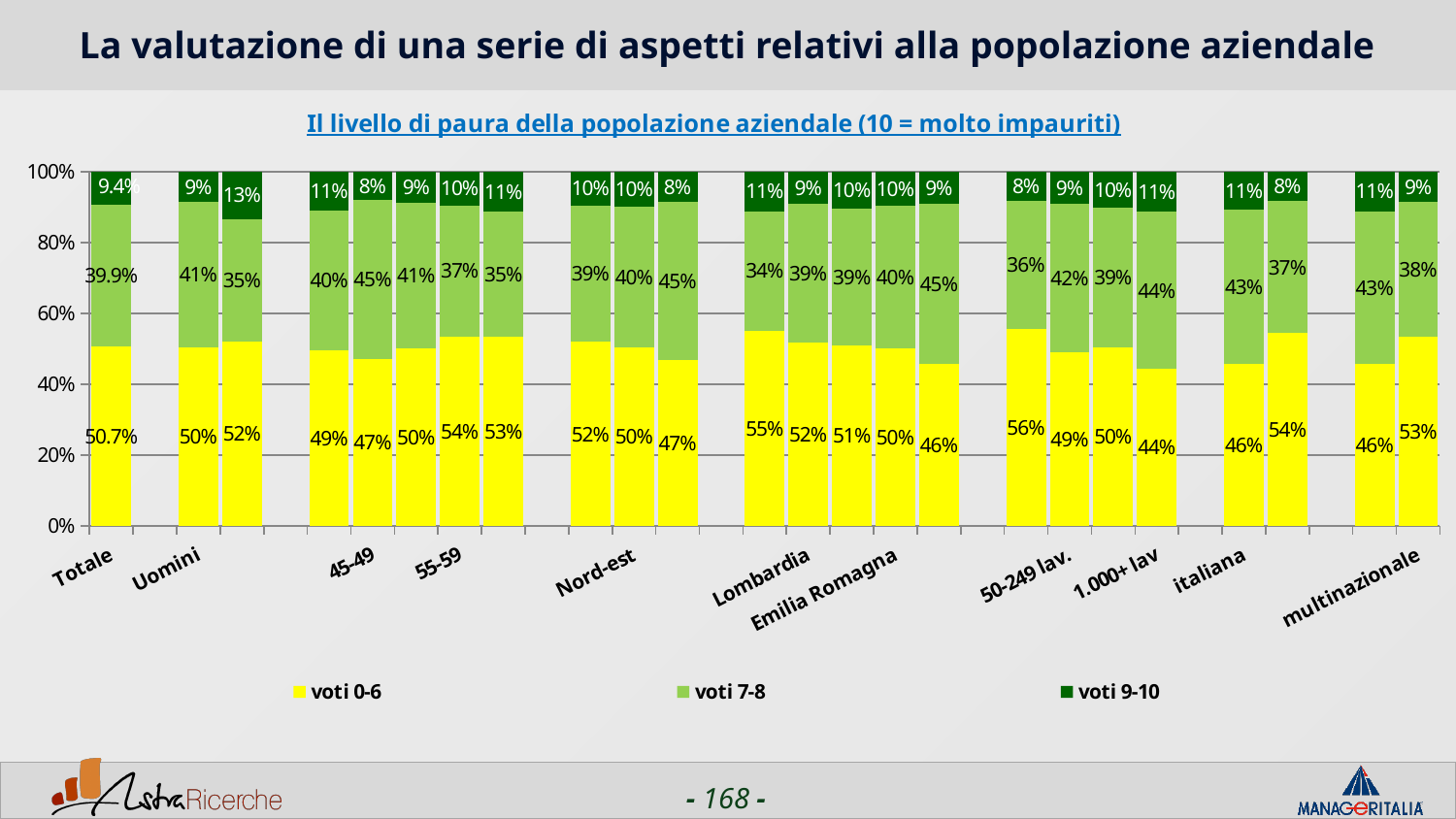
What is the value of the 'voti 9-10' series for Totale? 9.4% What is the value of the 'voti 9-10' series for Lombardia? 9% What is the value of the 'voti 0-6' series for Totale? 50.7% What is the value of the 'voti 7-8' series for italiana? 43% What is the value of the 'voti 0-6' series for multinazionale? 53% For Uomini, which is larger: the 'voti 0-6' value or the 'voti 7-8' value? voti 0-6 How many series does the legend list? 3 What is the value of the 'voti 7-8' series for Uomini? 41% What kind of chart is shown on the slide? Stacked bar chart For Totale, what is the difference between the 'voti 0-6' value and the 'voti 7-8' value? 10.8 percentage points What is the title of the chart? Il livello di paura della popolazione aziendale (10 = molto impauriti) What are the three legend entries of the chart? voti 0-6, voti 7-8, voti 9-10